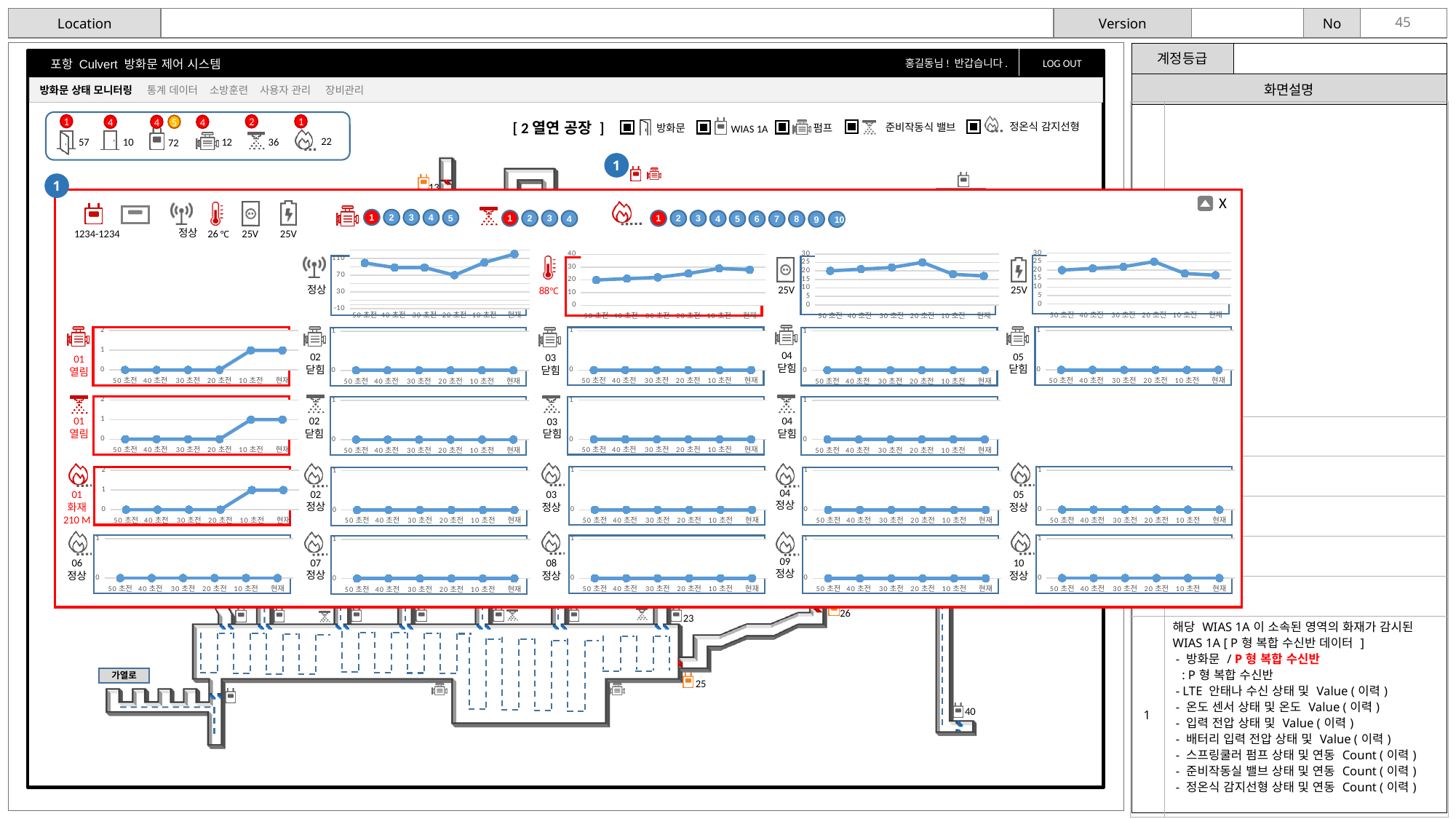
What is the label of the last point on the x axis of the pump 01 열림 chart? 현재 In the pump 01 열림 chart, what is the value at 현재? 1 In the antenna signal chart at the top left (next to the 정상 antenna icon), is the value at 현재 greater or less than 70? greater In the fire detector 01 화재 210 M chart, what is the value at 10 초전? 1 In the pump 02 닫힘 chart, what is the value at 현재? 0 In the temperature chart at the top (next to the 88℃ thermometer icon), is the value at 현재 greater or less than 20? greater In the sprinkler valve 01 열림 chart, what is the value at 20 초전? 0 How many time points are plotted along the x axis of the pump 01 열림 chart? 6 What kind of chart is used for the pump 01 열림 panel in the left column? line chart In the pump 01 열림 chart, do the values rise or fall from 50 초전 to 현재? rise In the pump 01 열림 chart, what is the value at 50 초전? 0 In the fire detector 02 정상 chart, do the values rise, fall, or stay flat across the x axis? stay flat